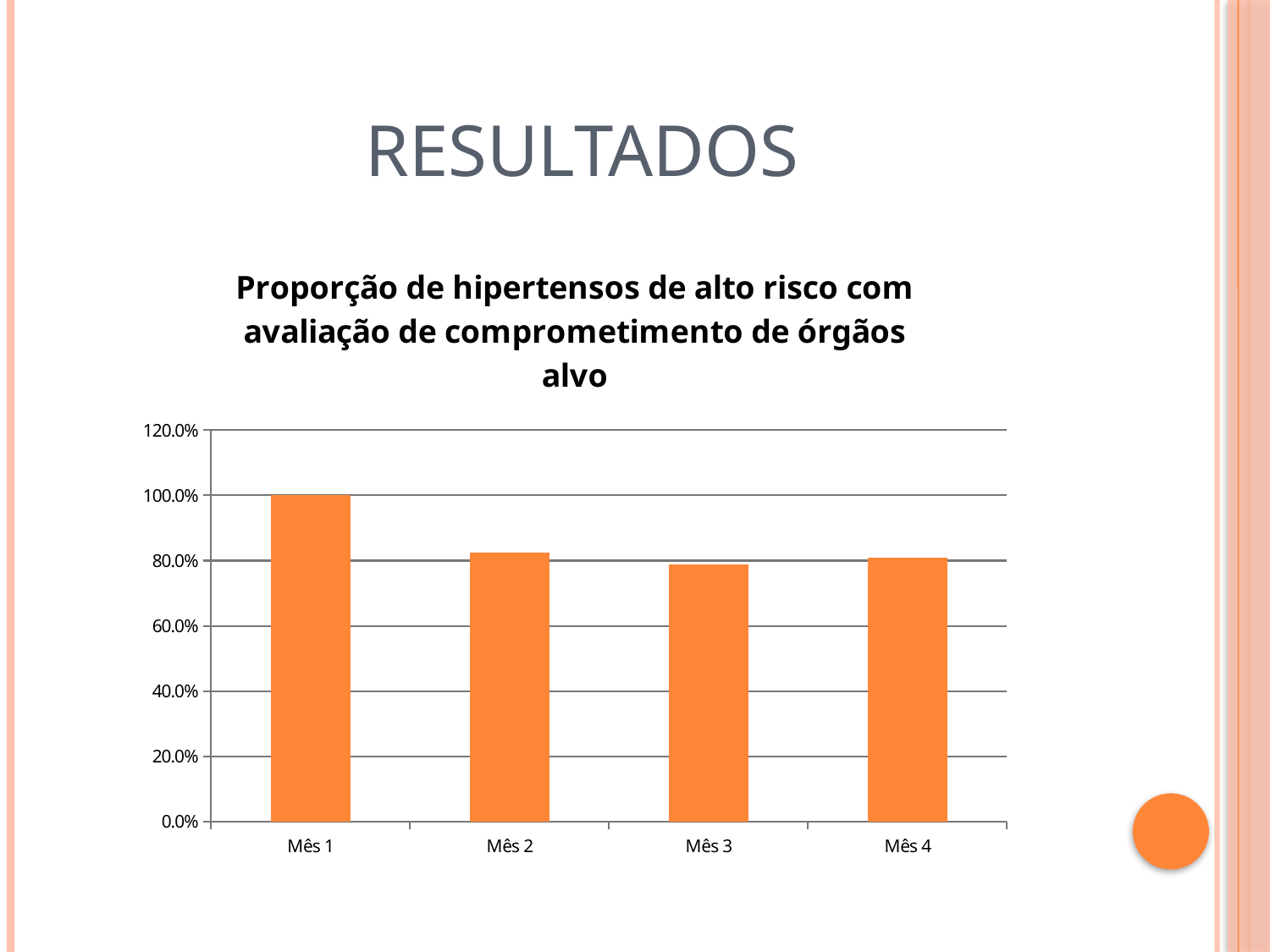
What is the value for Mês 1? 100.0% Is the value for Mês 3 greater or less than 60.0%? greater Which is larger, the value for Mês 1 or the value for Mês 3? Mês 1 Does the value rise or fall from Mês 1 to Mês 2? fall What is the title of the chart? Proporção de hipertensos de alto risco com avaliação de comprometimento de órgãos alvo Which is larger, the value for Mês 2 or the value for Mês 1? Mês 1 Is the value for Mês 2 greater or less than 100.0%? less Is the value for Mês 4 greater or less than 100.0%? less Which month has the highest value? Mês 1 How many categories (months) are shown on the x axis? 4 What type of chart is shown on the slide? bar chart What is the highest value shown on the y axis? 120.0%